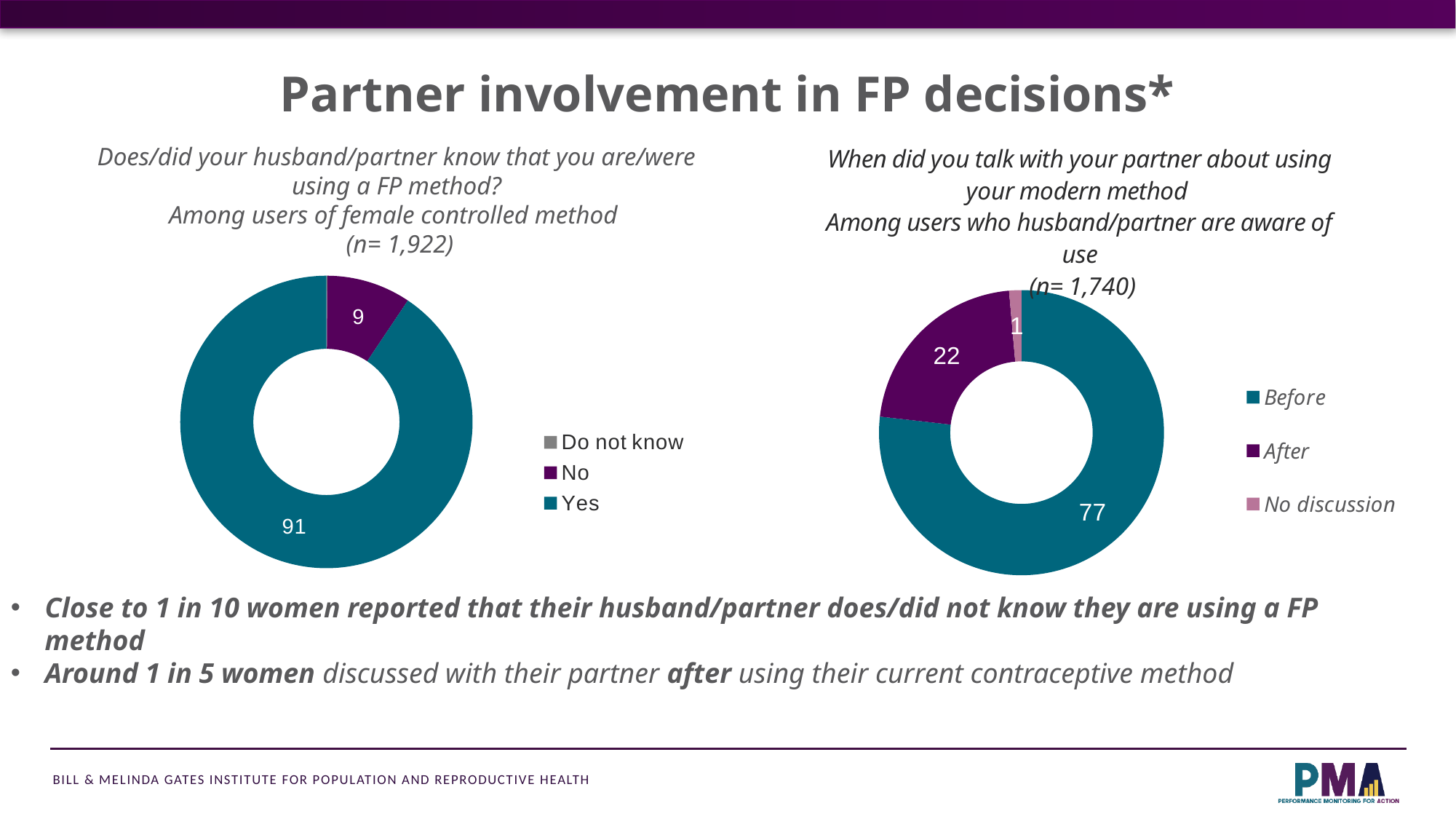
In the left chart (Does/did your husband/partner know that you are/were using a FP method?), what is the value for Yes? 91 In the right chart (When did you talk with your partner about using your modern method), what is the difference between the Before and After values? 55 In the right chart (When did you talk with your partner about using your modern method), what is the value for After? 22 In the right chart (When did you talk with your partner about using your modern method), which category has the largest share? Before In the right chart (When did you talk with your partner about using your modern method), which category has the smallest share? No discussion In the left chart (Does/did your husband/partner know that you are/were using a FP method?), what is the difference between the Yes and No values? 82 What type of chart is the left chart (Does/did your husband/partner know that you are/were using a FP method?)? Doughnut (pie) chart How many entries does the legend of the right chart (When did you talk with your partner about using your modern method) list? 3 In the left chart (Does/did your husband/partner know that you are/were using a FP method?), what is the value for No? 9 In the right chart (When did you talk with your partner about using your modern method), what is the value for Before? 77 In the right chart (When did you talk with your partner about using your modern method), what is the value for No discussion? 1 In the right chart (When did you talk with your partner about using your modern method), which is larger, After or No discussion? After